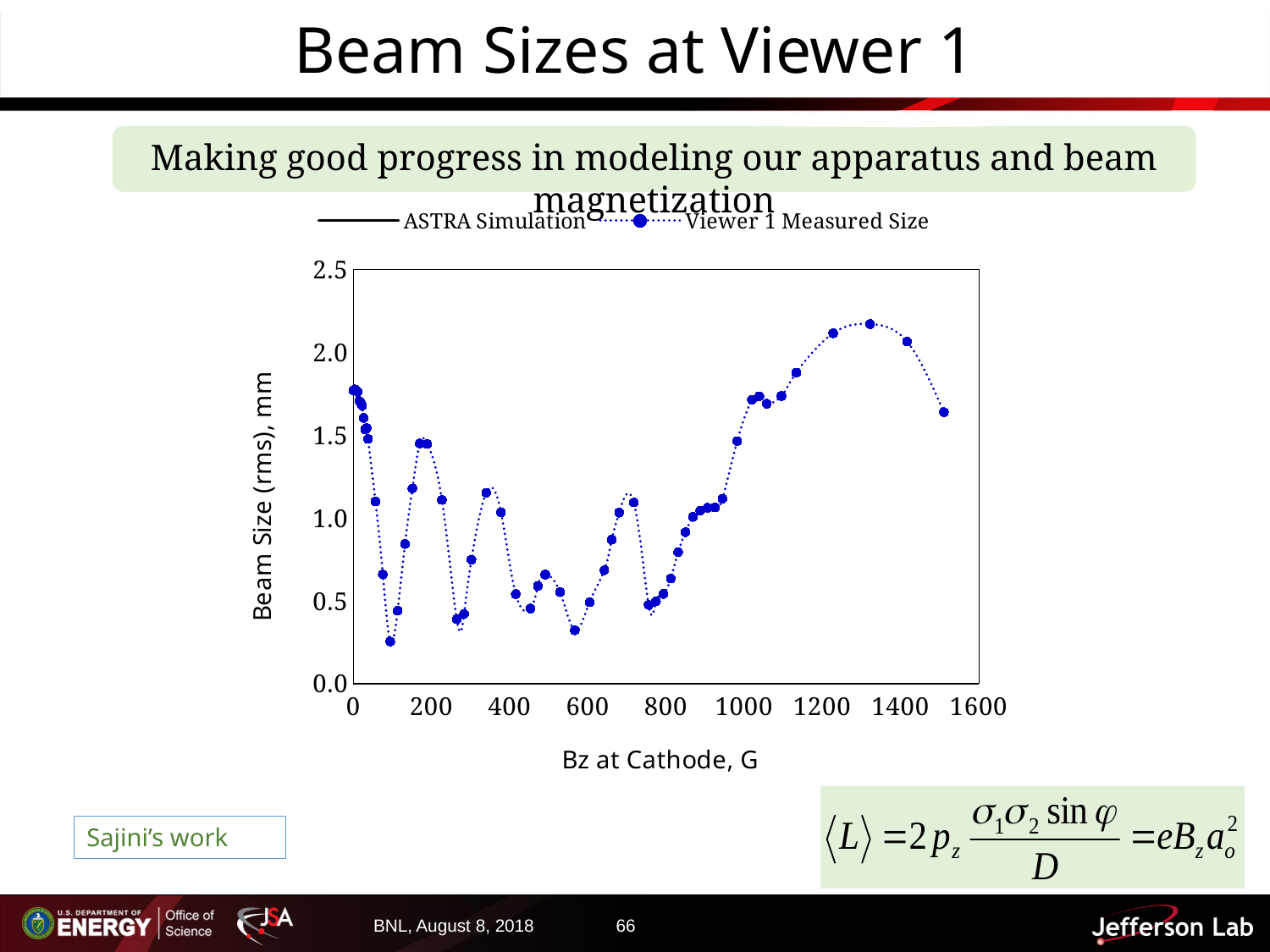
Which is larger, the measured beam size at about 1300 G or at 0 G? about 1300 G What is the label of the x axis? Bz at Cathode, G Is the measured beam size at Bz = 0 G greater or less than 1.5? greater Which is larger, the measured beam size at 0 G or at about 100 G? 0 G Between about 1000 G and 1300 G, does the measured beam size rise or fall as Bz increases? rise What kind of chart is shown on the slide? line chart How many series does the legend list? 2 Is the lowest measured beam size (near 100 G) greater or less than 0.5? less What is the label of the y axis? Beam Size (rms), mm Is the measured beam size at about 1500 G greater or less than 1.5? greater